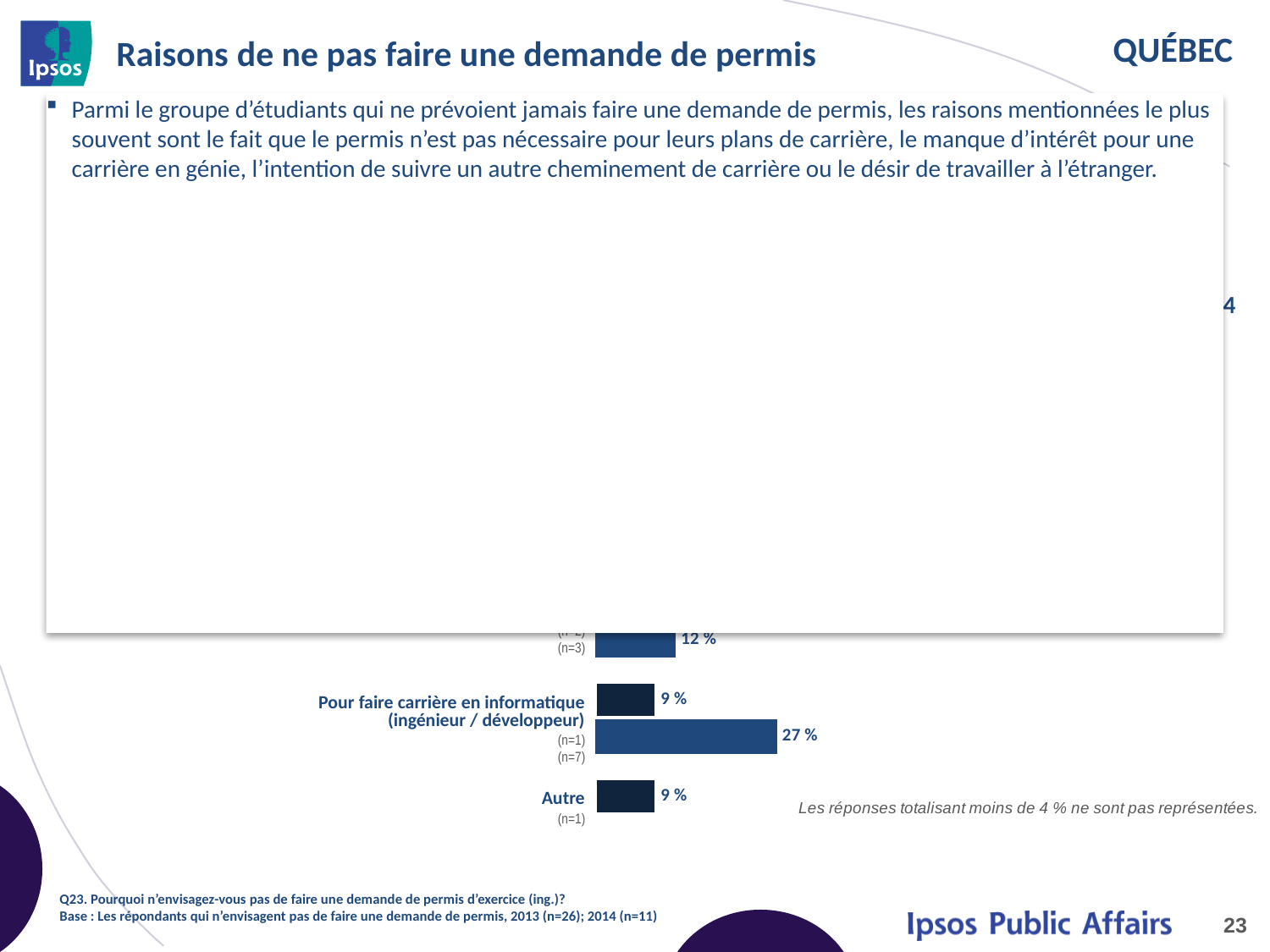
Is the value for "Autre" greater or less than 10 %? less For "Pour faire carrière en informatique (ingénieur / développeur)", which bar is larger, the dark navy bar or the lighter blue bar? the lighter blue bar Which of the visible labelled values is the highest: 12 %, 9 %, 27 % or 9 %? 27 % Is the value of the lighter blue bar for "Pour faire carrière en informatique (ingénieur / développeur)" greater or less than 20 %? greater What is the value of the dark navy bar for "Pour faire carrière en informatique (ingénieur / développeur)"? 9 % What is the value of the lighter blue bar for "Pour faire carrière en informatique (ingénieur / développeur)"? 27 % What is the value shown for the "Autre" category? 9 % What is the difference between the two bars for "Pour faire carrière en informatique (ingénieur / développeur)"? 18 % What kind of chart is shown on the slide? bar chart What note appears at the bottom right of the chart about responses not shown? Les réponses totalisant moins de 4 % ne sont pas représentées. What is the sample size (n) shown under the "Autre" category? n=1